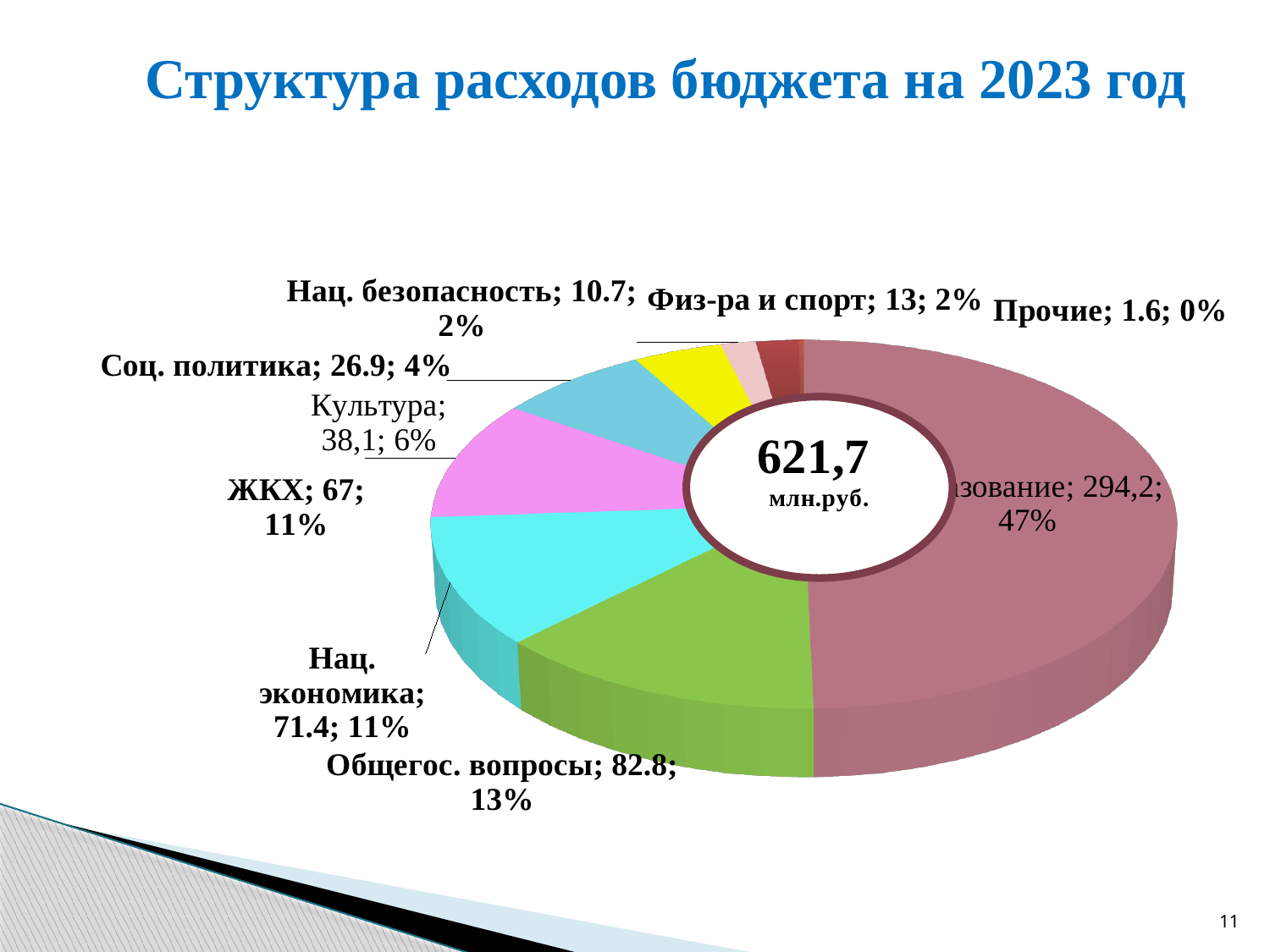
Which category has the smallest slice of the pie? Прочие What share of the pie does Культура represent? 6% What value is shown for Общегос. вопросы? 82.8 What share of the pie does ЖКХ represent? 11% Which is larger, the value for Физ-ра и спорт or the value for Нац. безопасность? Физ-ра и спорт How many categories are shown in the pie chart? 9 What is the title of the chart on the slide? Структура расходов бюджета на 2023 год What kind of chart is shown on the slide? pie chart What value is shown for the largest slice of the pie? 294,2 What value is shown for Соц. политика? 26.9 What is the difference between the values for Общегос. вопросы and Нац. экономика? 11.4 What total is printed in the centre of the pie chart? 621,7 млн.руб.